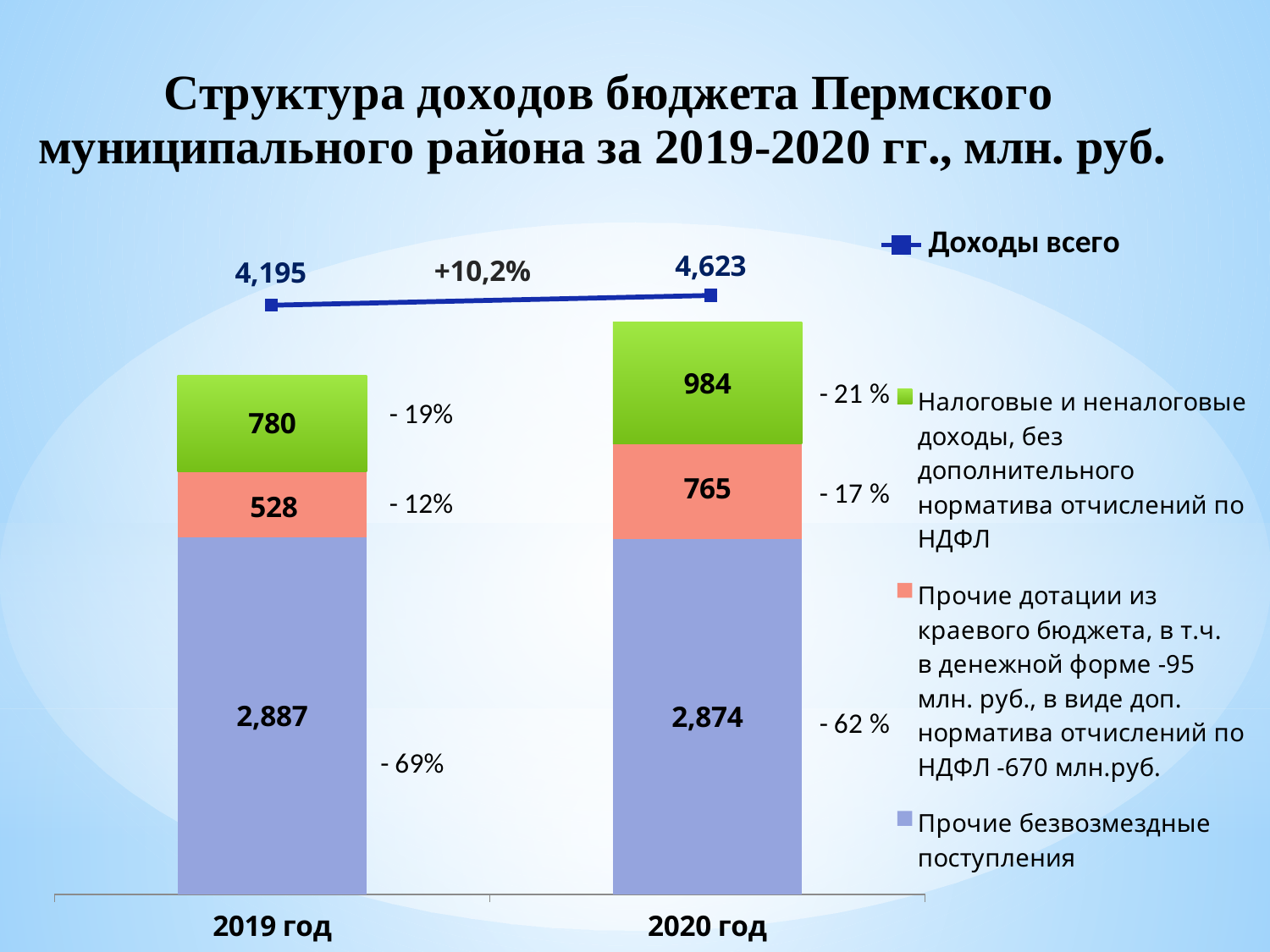
How many entries does the legend list? 4 What is the 'Доходы всего' value for 2020 год? 4,623 What is the value of the 'Прочие дотации из краевого бюджета' segment for 2019 год? 528 What is the value of the 'Налоговые и неналоговые доходы' segment for 2020 год? 984 What is the value of the 'Прочие безвозмездные поступления' segment for 2019 год? 2,887 What is the difference between the 'Прочие дотации из краевого бюджета' values for 2020 год and 2019 год? 237 Which year has the higher 'Доходы всего' value? 2020 год What type of chart is shown on the slide? Stacked bar chart with a line Which segment is the largest in the 2020 год bar? Прочие безвозмездные поступления How many years (categories) are shown on the x axis? 2 By how much did the 'Налоговые и неналоговые доходы' segment increase from 2019 год to 2020 год? 204 What percentage change in total income is shown between 2019 год and 2020 год? +10,2%